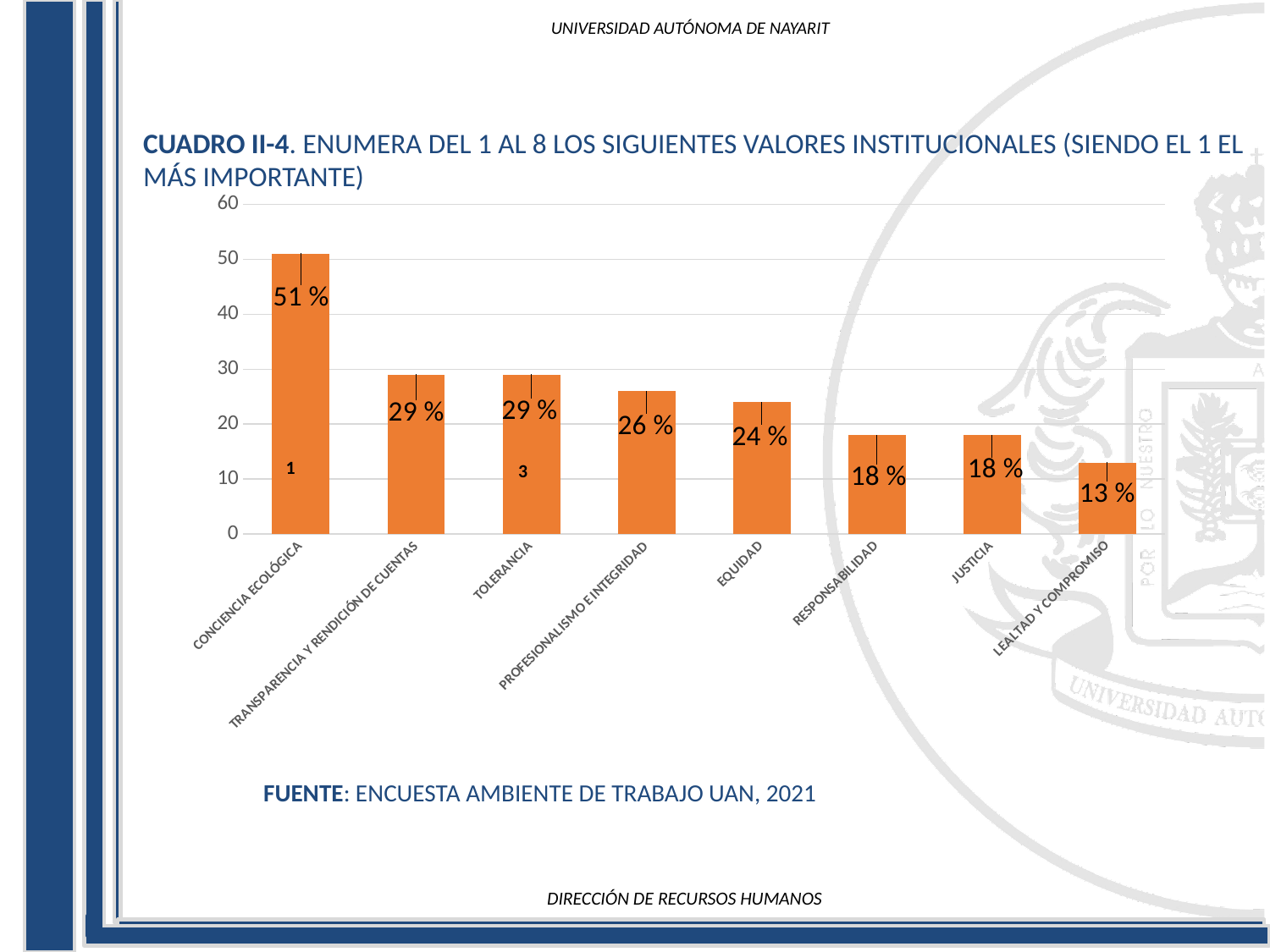
What is the difference between the values for CONCIENCIA ECOLÓGICA and TOLERANCIA? 22 % What source is cited below the chart? ENCUESTA AMBIENTE DE TRABAJO UAN, 2021 How many categories are plotted in the chart? 8 What is the value for CONCIENCIA ECOLÓGICA? 51 % Which category has the highest value? CONCIENCIA ECOLÓGICA What is the value for EQUIDAD? 24 % Do the values generally rise or fall from left to right along the x axis? fall What is the value for LEALTAD Y COMPROMISO? 13 % Which category has the lowest value? LEALTAD Y COMPROMISO Which is larger, the value for EQUIDAD or the value for JUSTICIA? EQUIDAD What kind of chart is shown on the slide? bar chart What is the value for PROFESIONALISMO E INTEGRIDAD? 26 %